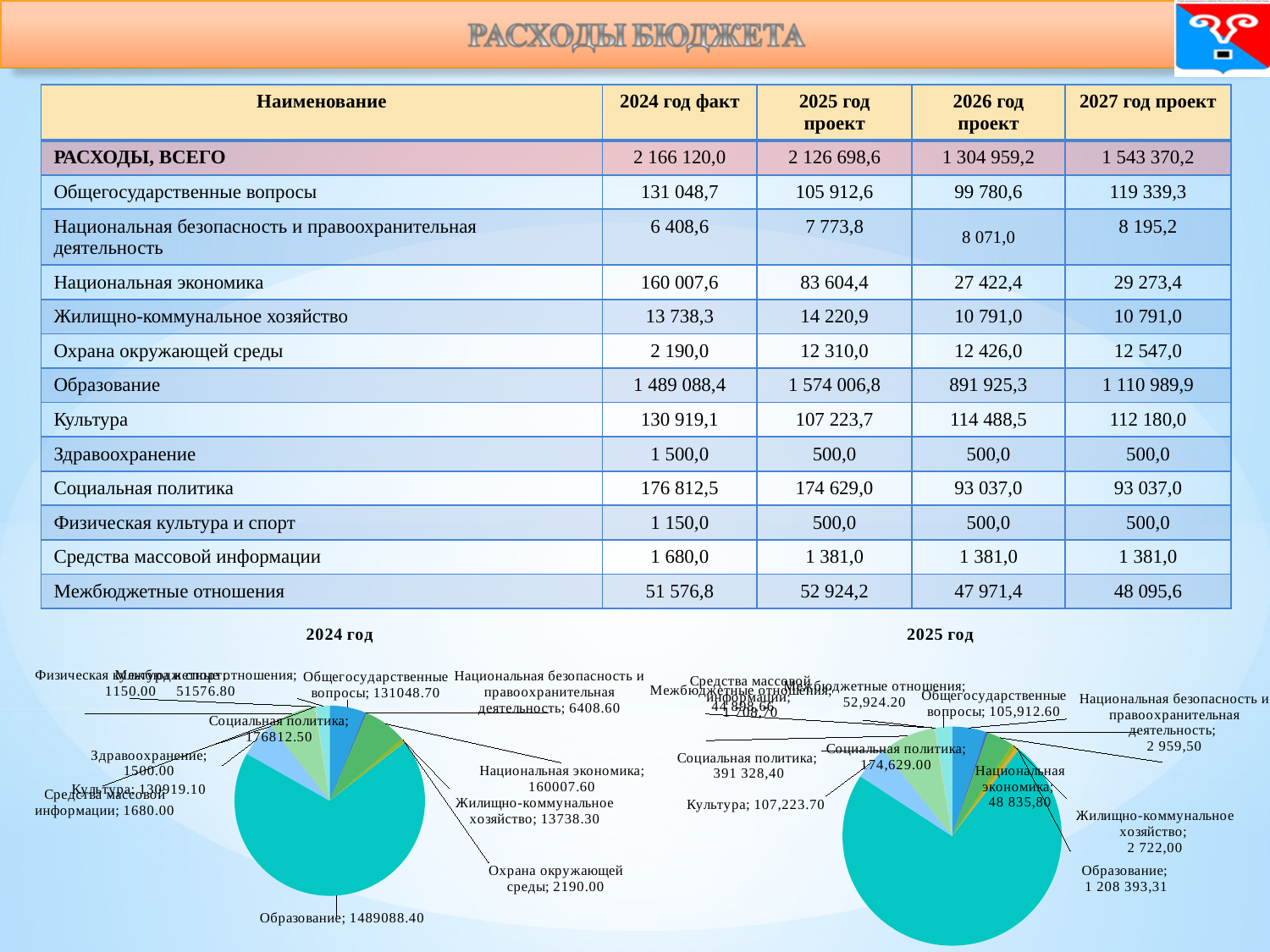
In the "2024 год" chart, what is the value for Национальная экономика? 160007.60 In the "2024 год" chart, which category has the largest slice? Образование In the "2024 год" chart, which is larger: Социальная политика or Национальная экономика? Социальная политика In the "2024 год" chart, which category has the smallest value? Физическая культура и спорт In the "2024 год" chart, what is the value for Образование? 1489088.40 How many categories are shown in the "2024 год" pie chart? 12 What are the titles of the two pie charts on the slide? 2024 год and 2025 год In the "2024 год" chart, what is the difference between Социальная политика and Национальная экономика? 16804.90 What kind of chart is the "2024 год" chart? pie chart In the "2024 год" chart, what is the difference between Охрана окружающей среды and Здравоохранение? 690.00 In the "2025 год" chart, what is the value for Образование? 1 208 393,31 In the "2025 год" chart, what is the value for Общегосударственные вопросы? 105,912.60